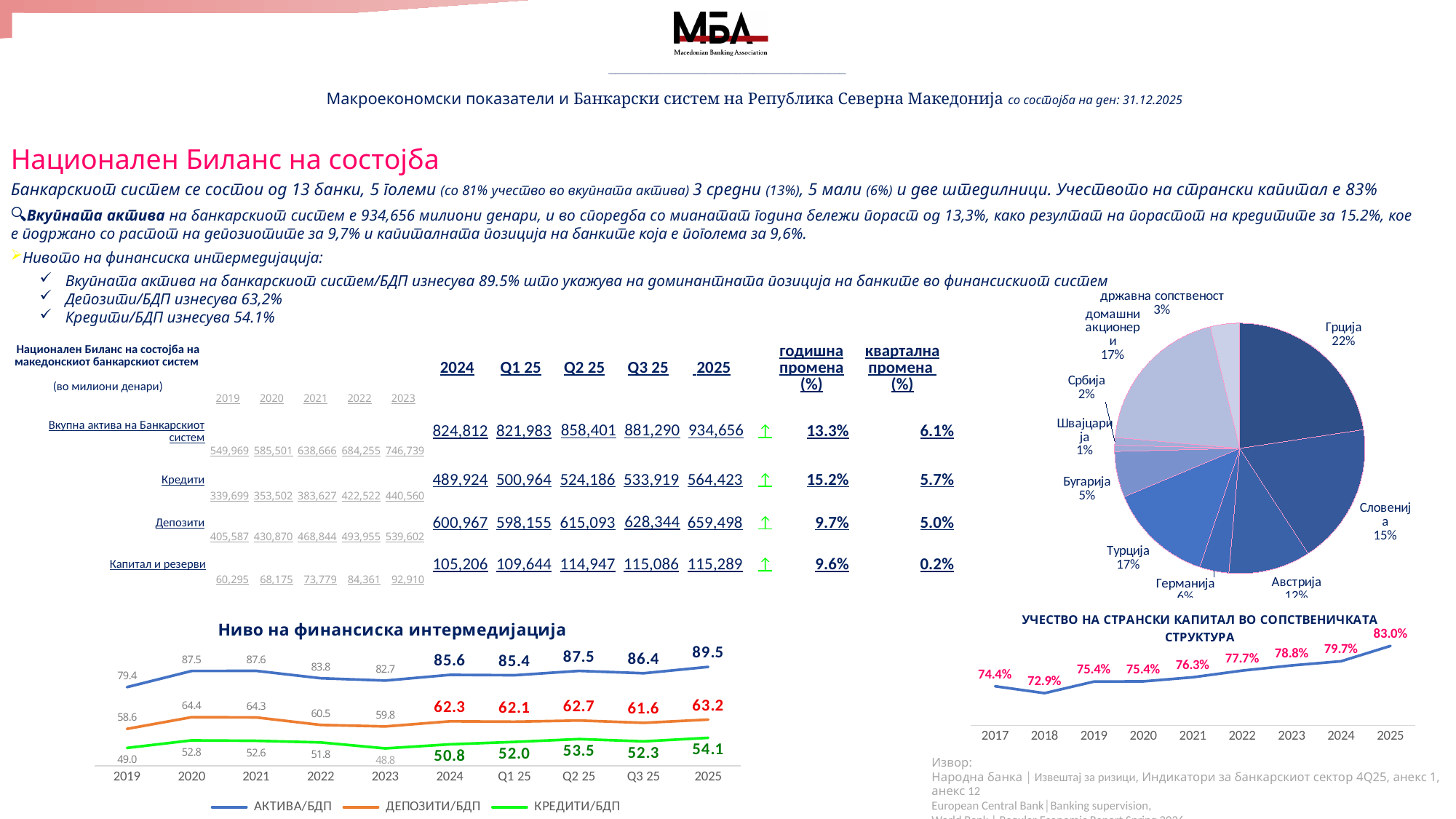
In the chart 'УЧЕСТВО НА СТРАНСКИ КАПИТАЛ ВО СОПСТВЕНИЧКАТА СТРУКТУРА', by how many percentage points is the 2025 value higher than the 2017 value? 8.6 What kind of chart is 'УЧЕСТВО НА СТРАНСКИ КАПИТАЛ ВО СОПСТВЕНИЧКАТА СТРУКТУРА'? line chart In the pie chart on the right, what share does Грција hold? 22% How many data points are plotted in the chart 'УЧЕСТВО НА СТРАНСКИ КАПИТАЛ ВО СОПСТВЕНИЧКАТА СТРУКТУРА'? 9 In the chart 'Ниво на финансиска интермедијација', in which period is КРЕДИТИ/БДП highest? 2025 How many series does the legend of the chart 'Ниво на финансиска интермедијација' list? 3 In the pie chart on the right, which category has the largest slice? Грција In the chart 'Ниво на финансиска интермедијација', is ДЕПОЗИТИ/БДП higher in 2020 or in 2025? 2020 In the chart 'УЧЕСТВО НА СТРАНСКИ КАПИТАЛ ВО СОПСТВЕНИЧКАТА СТРУКТУРА', do the values rise or fall from 2018 to 2025? rise In the chart 'УЧЕСТВО НА СТРАНСКИ КАПИТАЛ ВО СОПСТВЕНИЧКАТА СТРУКТУРА', what is the value for 2025? 83.0% In the chart 'УЧЕСТВО НА СТРАНСКИ КАПИТАЛ ВО СОПСТВЕНИЧКАТА СТРУКТУРА', which year has the lowest value? 2018 In the chart 'Ниво на финансиска интермедијација', what is the value of АКТИВА/БДП for 2025? 89.5